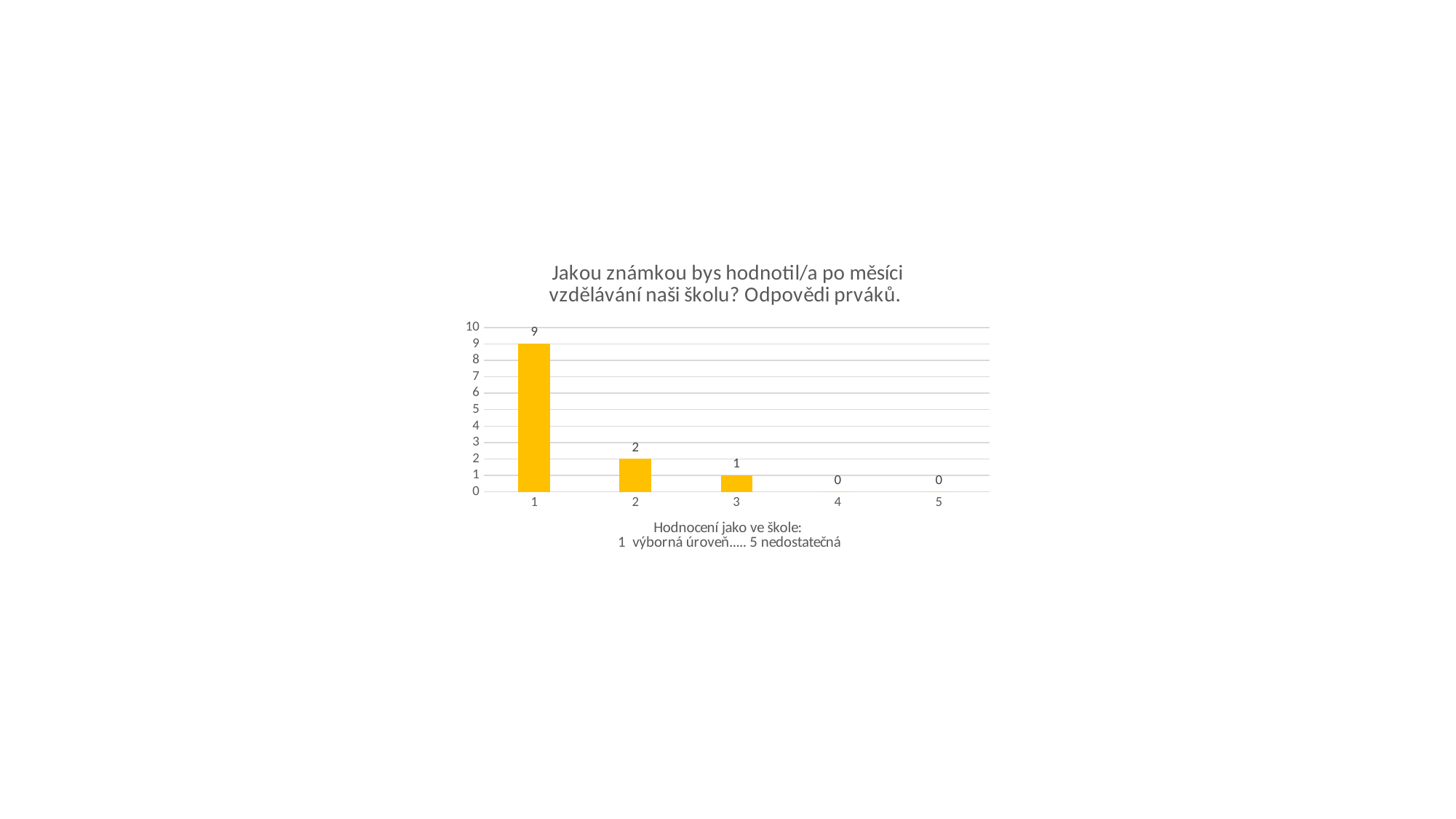
Is the value for grade 1 greater or less than 5? greater What value is shown for grade 1? 9 What value is shown for grade 5? 0 What value is shown for grade 2? 2 What is the difference between the values for grade 1 and grade 2? 7 Do the values rise or fall from grade 1 to grade 5? fall What value is shown for grade 3? 1 Which grade has the highest value? 1 What is the title of the chart? Jakou známkou bys hodnotil/a po měsíci vzdělávání naši školu? Odpovědi prváků. Which is larger, the value for grade 2 or the value for grade 3? grade 2 How many categories are shown on the x axis? 5 What kind of chart is shown on the slide? bar chart